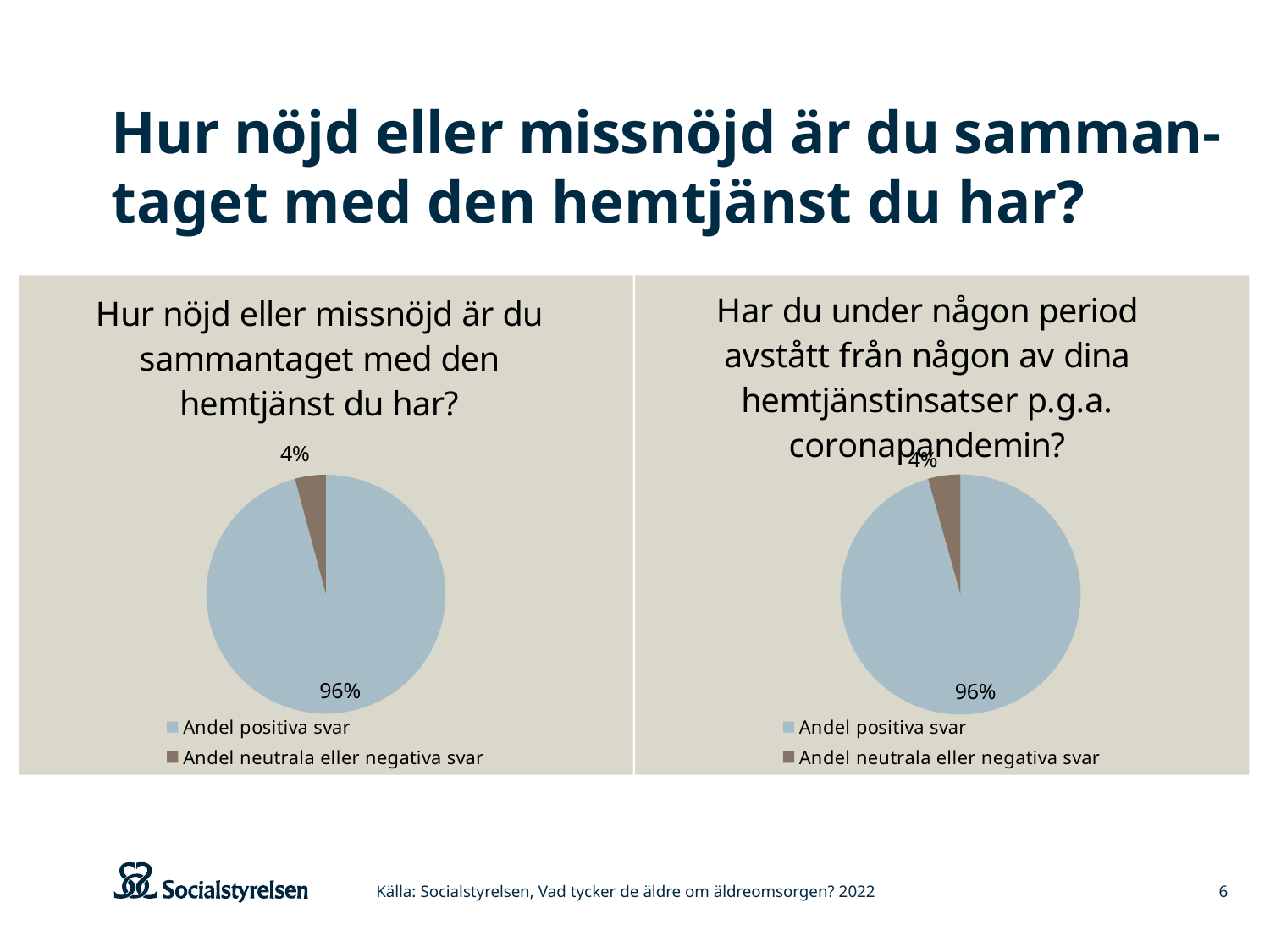
In the right pie chart, what share is labelled for 'Andel positiva svar'? 96% What type of chart is shown on the left side of the slide? Pie chart What is the title of the right pie chart? Har du under någon period avstått från någon av dina hemtjänstinsatser p.g.a. coronapandemin? In the left pie chart, what share is labelled for 'Andel positiva svar'? 96% In the right pie chart, what share is labelled for 'Andel neutrala eller negativa svar'? 4% How many slices does the right pie chart have? 2 In the right pie chart, which category has the smallest slice? Andel neutrala eller negativa svar In the left pie chart, what share is labelled for 'Andel neutrala eller negativa svar'? 4% In the right pie chart, which is larger: 'Andel positiva svar' or 'Andel neutrala eller negativa svar'? Andel positiva svar In the left pie chart, which category has the largest slice? Andel positiva svar How many entries does the legend of the left pie chart list? 2 In the left pie chart, what is the difference in percentage points between 'Andel positiva svar' and 'Andel neutrala eller negativa svar'? 92 percentage points